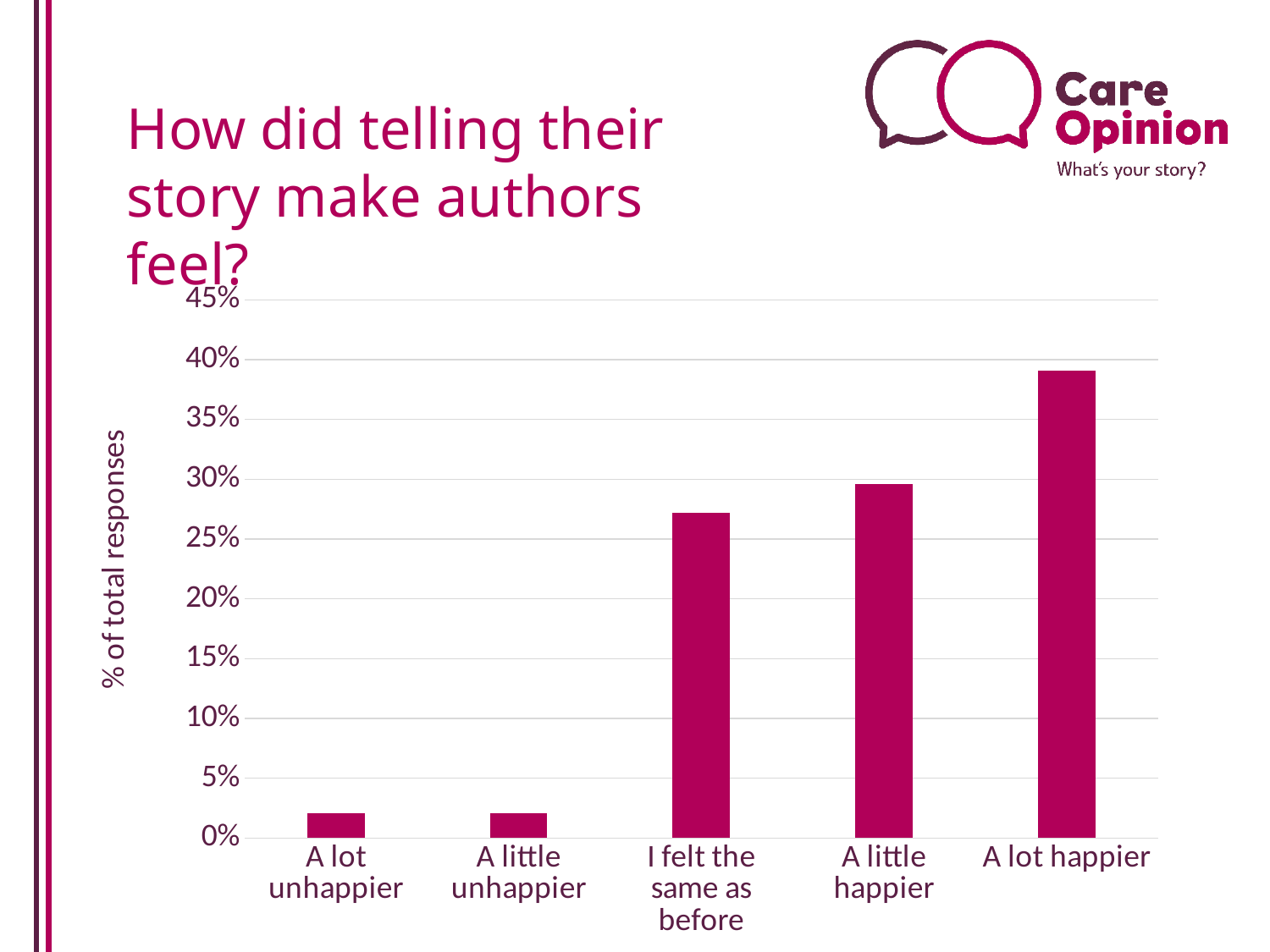
Is the value for "I felt the same as before" greater or less than 25%? greater Which is larger, the value for "A lot happier" or the value for "I felt the same as before"? A lot happier What is the label on the vertical axis of the chart? % of total responses Is the value for "A lot unhappier" greater or less than 5%? less Is the value for "A lot happier" greater or less than 40%? less Which category has the highest value in the chart? A lot happier What kind of chart is shown on the slide? bar chart What is the title of the chart on the slide? How did telling their story make authors feel? How many categories are shown on the x axis of the chart? 5 Do the values generally rise or fall moving from left to right along the x axis? rise